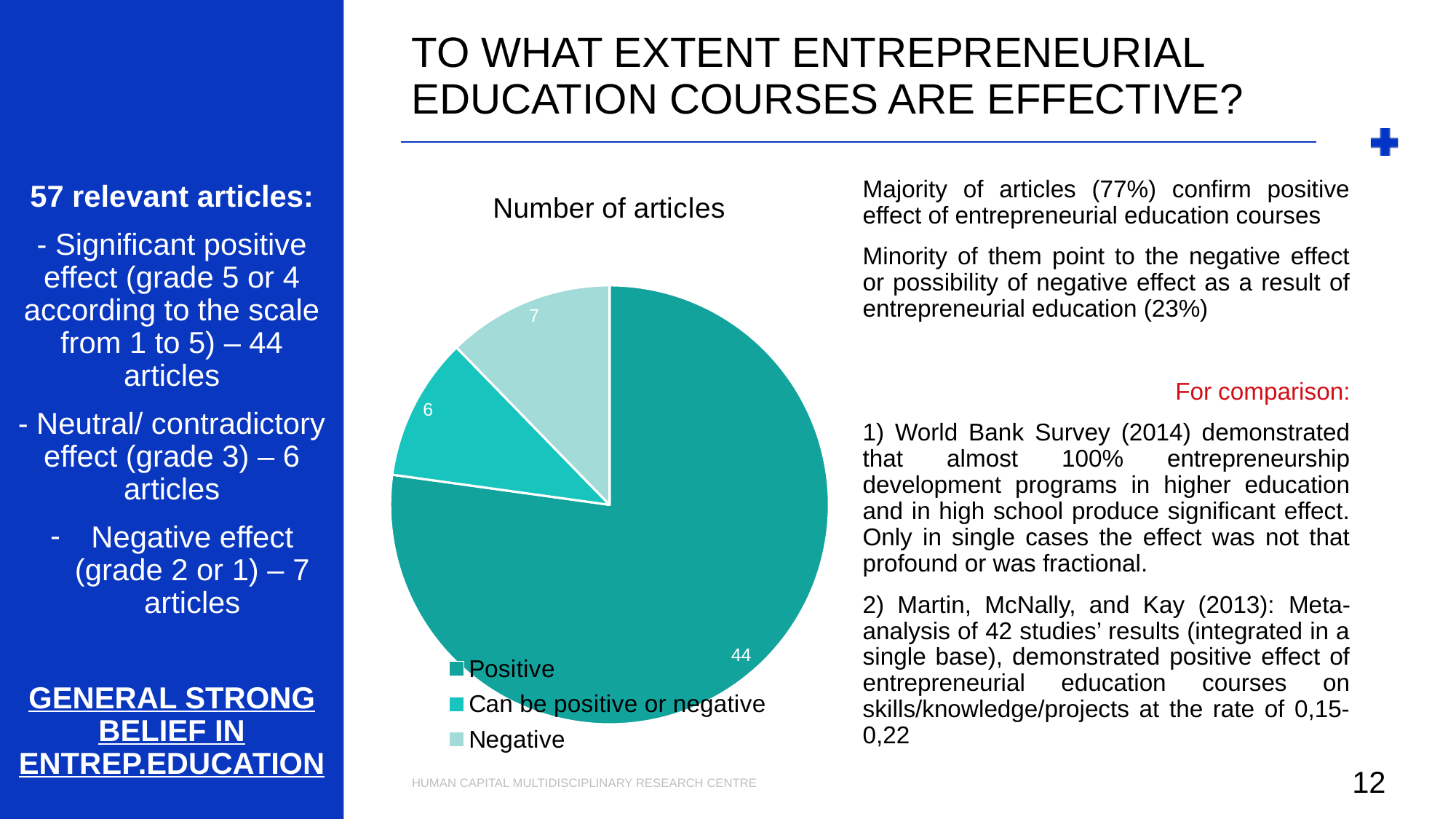
Which category has the largest slice of the pie? Positive What is the number of articles for the Negative slice? 7 Which is larger, the Negative value or the 'Can be positive or negative' value? Negative What is the number of articles for the Positive slice? 44 What type of chart is shown on the slide? Pie chart How many entries does the chart legend list? 3 Which category has the smallest slice of the pie? Can be positive or negative What is the number of articles for the 'Can be positive or negative' slice? 6 What is the difference between the Positive and Negative values? 37 What share of the pie does the Positive slice represent? 77% What is the title of the chart? Number of articles How many slices does the pie chart have? 3